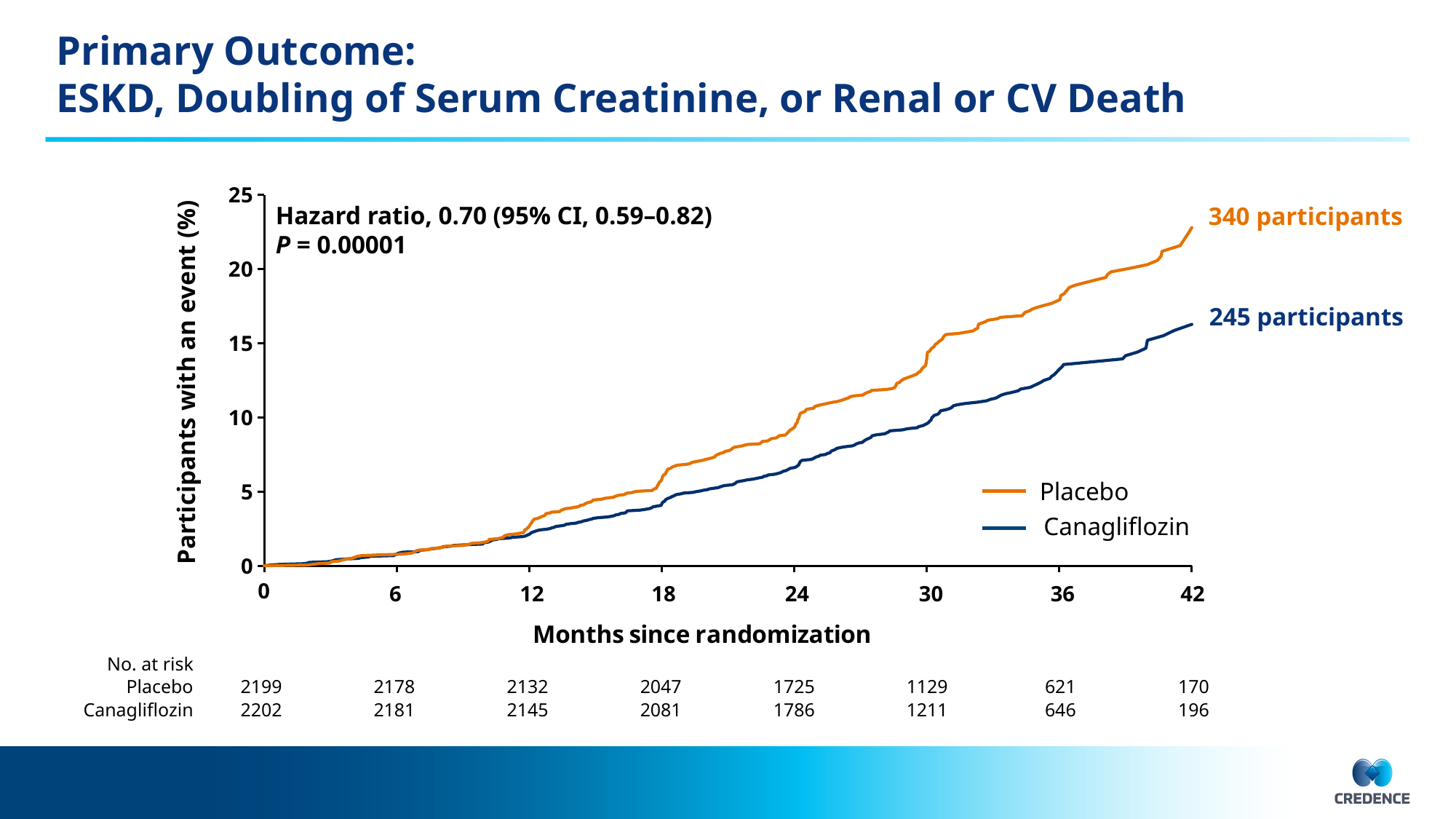
What is the difference between the number of participants with an event in the Placebo group and in the Canagliflozin group? 95 Is the value for Canagliflozin at 24 months greater or less than 10? less Do the values for both series rise or fall as months since randomization increase? Rise How many participants in the Canagliflozin group had an event, according to the label at the end of the blue line? 245 participants How many series does the legend list? 2 Is the value for Placebo at 42 months greater or less than 20? greater Is the value for Canagliflozin at 42 months greater or less than 20? less What kind of chart is shown on the slide? Line chart What hazard ratio is printed on the chart? 0.70 (95% CI, 0.59–0.82) In the 'No. at risk' table, how many Placebo participants were at risk at 24 months? 1725 How many participants in the Placebo group had an event, according to the label at the end of the orange line? 340 participants Which group has the higher percentage of participants with an event at 42 months, Placebo or Canagliflozin? Placebo